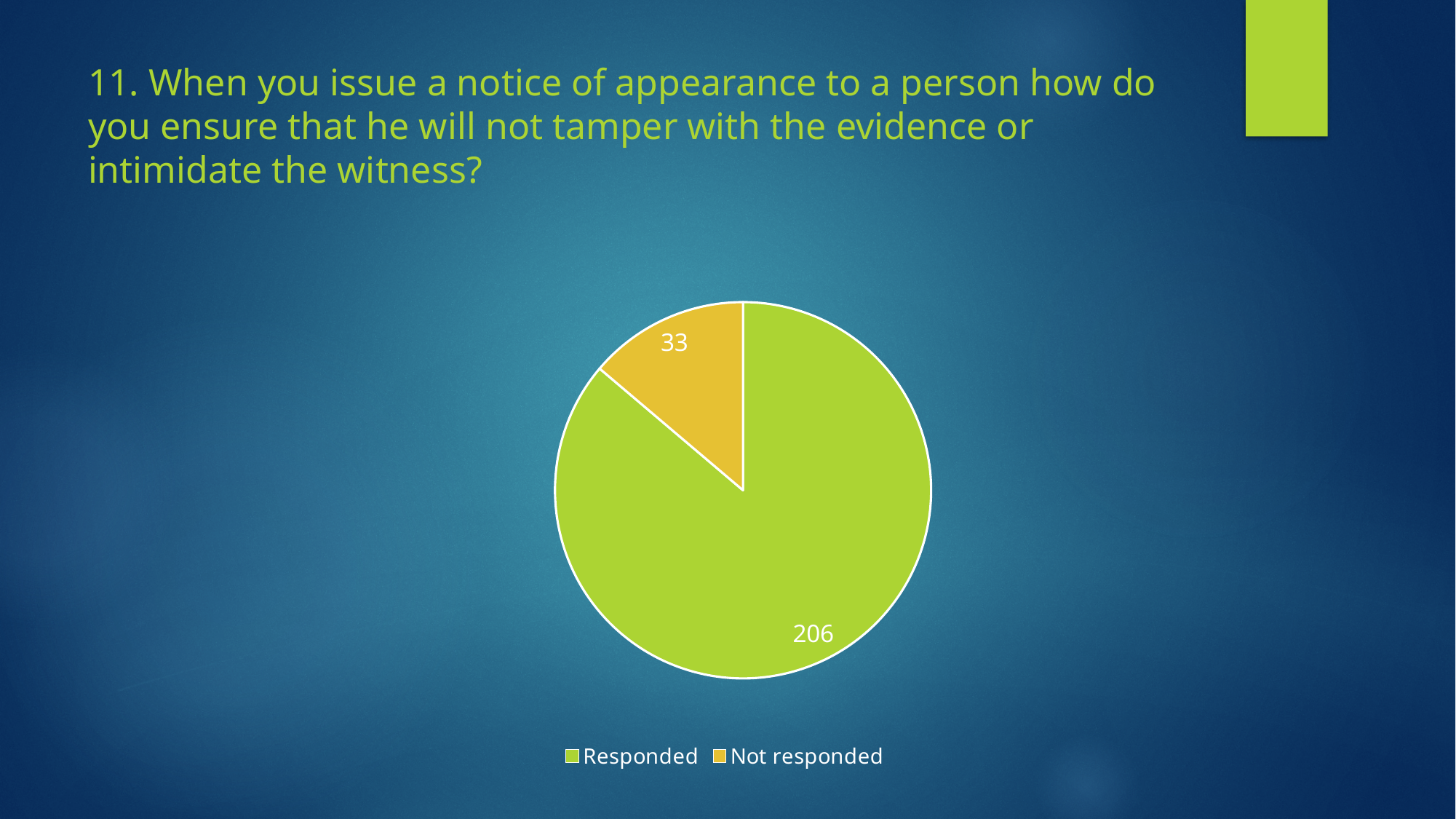
What is the difference between the Responded and Not responded values? 173 Which is larger, Responded or Not responded? Responded What colour is the Not responded slice? yellow/orange What is the total of the two slices? 239 How many slices does the pie chart have? 2 What is the value for Not responded? 33 Which category has the largest slice? Responded Where is the legend positioned relative to the pie? below the pie Which category has the smallest slice? Not responded What kind of chart is shown on the slide? pie chart How many entries does the legend list? 2 What is the value for Responded? 206